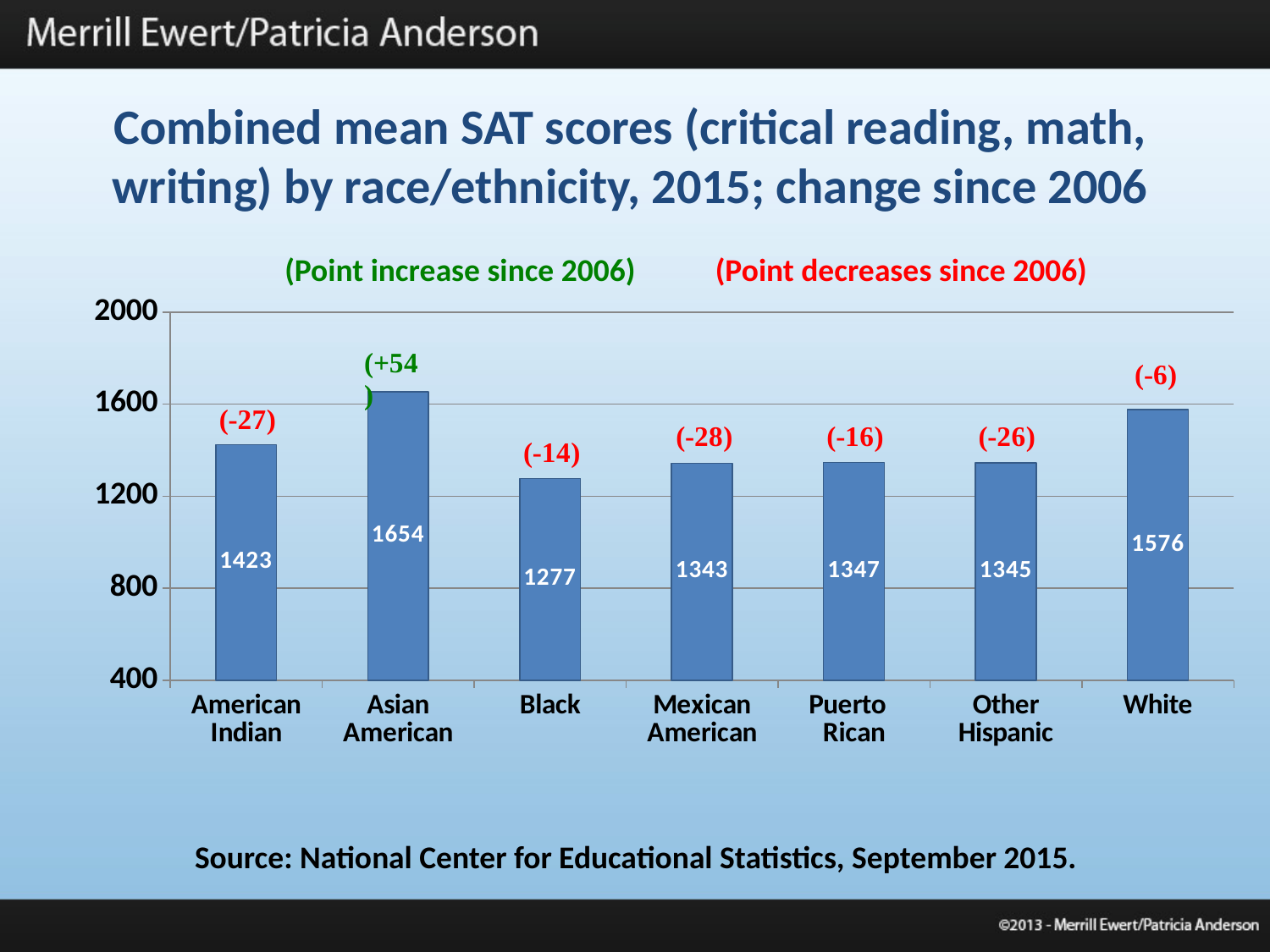
Which is larger, the combined mean SAT score for American Indian students or for Mexican American students? American Indian What is the combined mean SAT score for Black students? 1277 What kind of chart is shown on the slide? Bar chart What is the difference between the combined mean SAT scores of American Indian and Black students? 146 What is the combined mean SAT score for Asian American students? 1654 What is the combined mean SAT score for White students? 1576 What is the point change since 2006 shown for Asian American students? +54 Which race/ethnicity group has the lowest combined mean SAT score? Black What is the point change since 2006 shown for Mexican American students? -28 Which race/ethnicity group has the highest combined mean SAT score? Asian American What is the difference between the combined mean SAT scores of Asian American and White students? 78 How many race/ethnicity categories are shown in the chart? 7